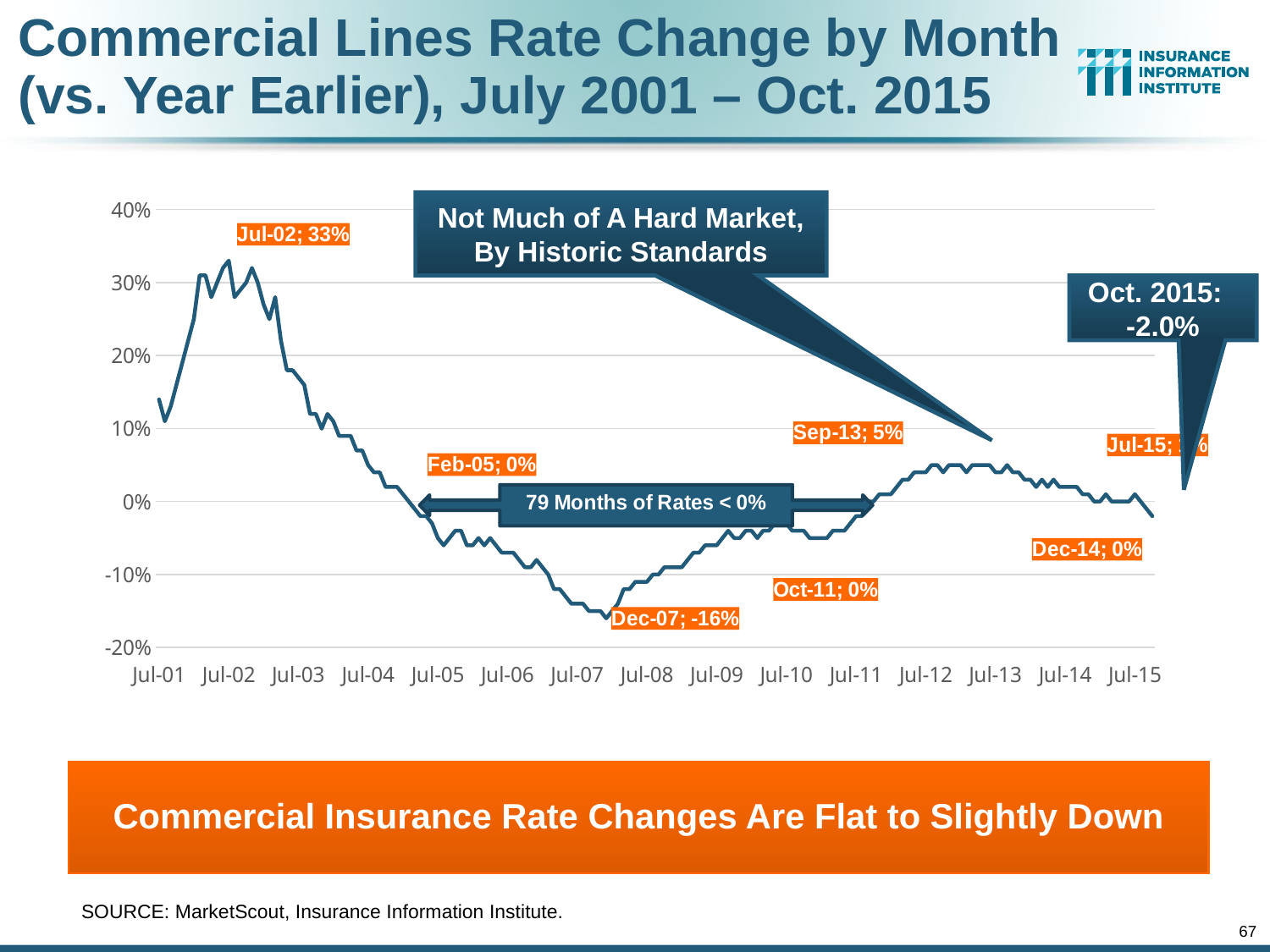
Which labeled month shows the lowest rate change? Dec-07 Which labeled month shows the highest rate change? Jul-02 What was the commercial lines rate change in Dec-07? -16% What type of chart is shown on the slide? line chart Which is larger, the rate change in Sep-13 or the rate change in Jul-02? Jul-02 What was the commercial lines rate change in Oct. 2015? -2.0% What was the commercial lines rate change in Jul-02? 33% What was the commercial lines rate change in Feb-05? 0% What was the commercial lines rate change in Sep-13? 5% Is the rate change in Jul-01 greater or less than 10%? greater What is the difference between the rate change in Jul-02 and the rate change in Dec-07? 49 percentage points According to the annotation on the chart, for how many months were rates below 0%? 79 months